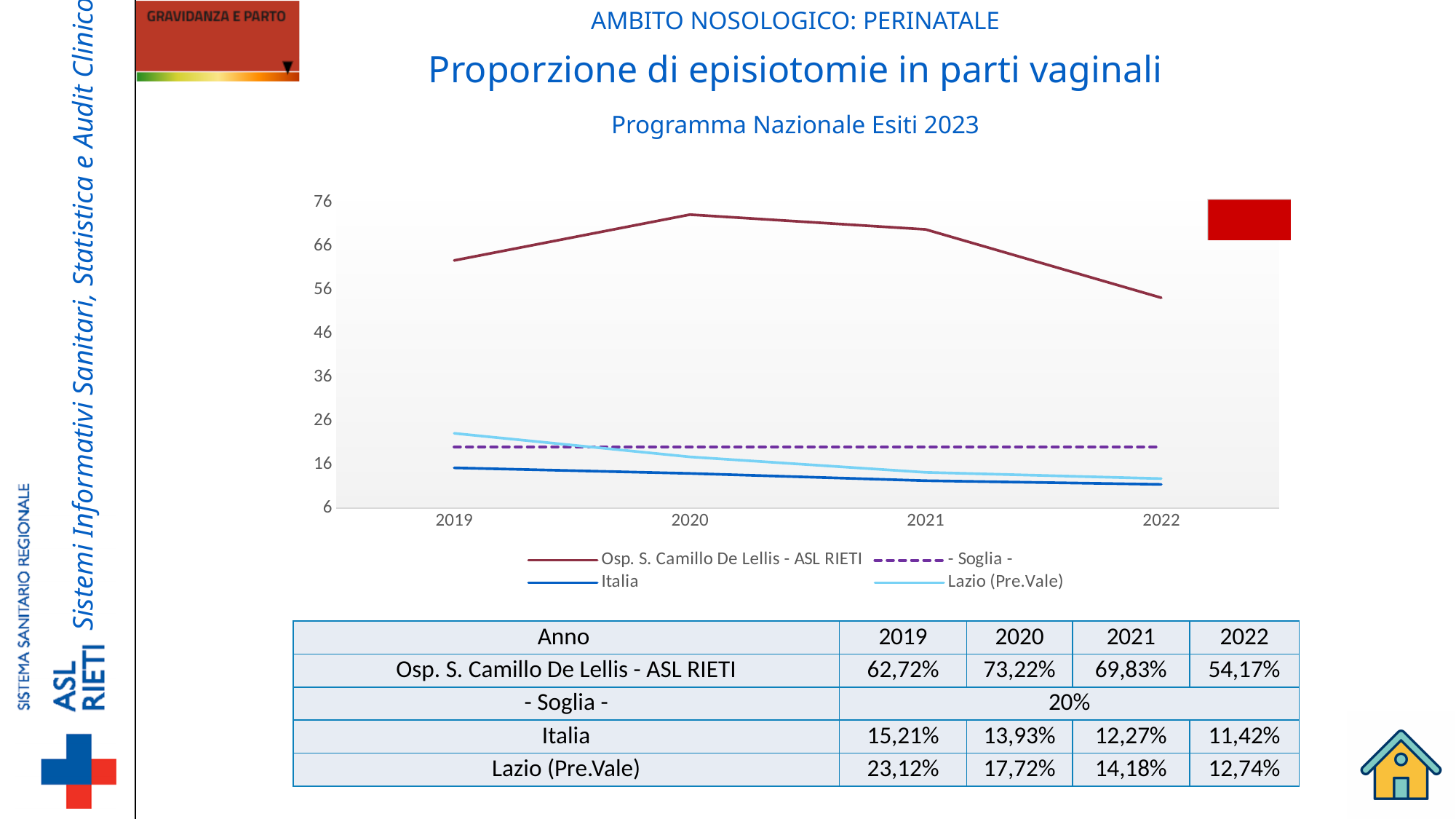
Which is larger in 2019: Lazio (Pre.Vale) or Italia? Lazio (Pre.Vale) In which year is the value for Osp. S. Camillo De Lellis - ASL RIETI lowest? 2022 In which year is the value for Osp. S. Camillo De Lellis - ASL RIETI highest? 2020 How many years are plotted along the x axis? 4 What kind of chart is shown on the slide? line chart What is the value of the - Soglia - line? 20% How many series does the chart legend list? 4 What is the value for Osp. S. Camillo De Lellis - ASL RIETI in 2020? 73,22% What is the difference between the Osp. S. Camillo De Lellis - ASL RIETI values for 2021 and 2022? 15,66% What is the value for Italia in 2022? 11,42% Does the value for Italia rise or fall from 2019 to 2022? fall What is the value for Lazio (Pre.Vale) in 2019? 23,12%